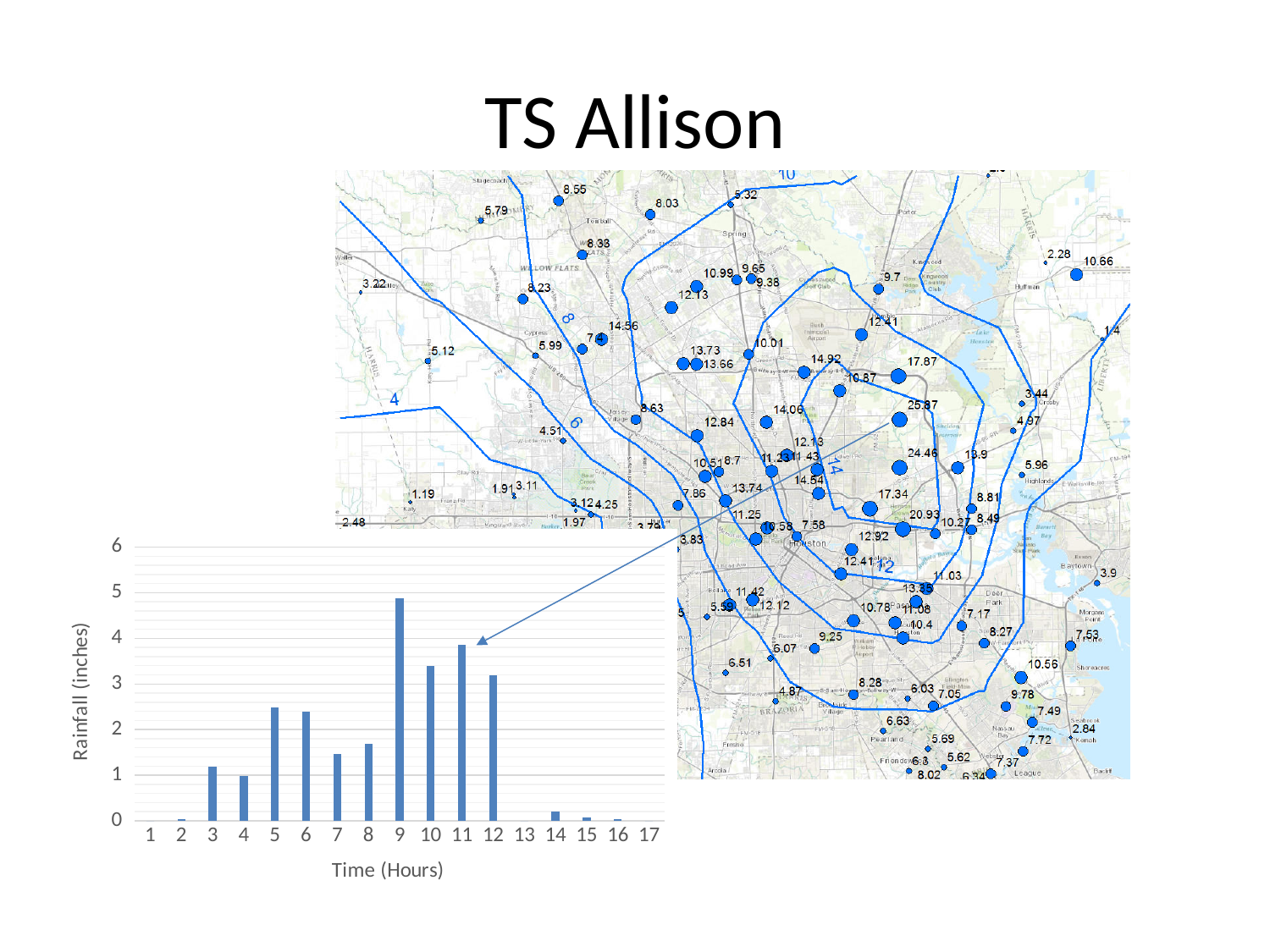
Which hour has more rainfall, hour 9 or hour 10? 9 How many time categories are shown on the x axis of the bar chart? 17 Which hour has more rainfall, hour 5 or hour 7? 5 Is the rainfall value for hour 14 greater or less than 1 inch? less What kind of chart is shown on the slide? bar chart What is the label of the x axis of the bar chart? Time (Hours) At which hour is the rainfall highest in the bar chart? 9 Is the rainfall value for hour 11 greater or less than 3 inches? greater What is the label of the y axis of the bar chart? Rainfall (inches) Is the rainfall value for hour 9 greater or less than 4 inches? greater Do the rainfall values generally rise or fall from hour 12 to hour 17? fall